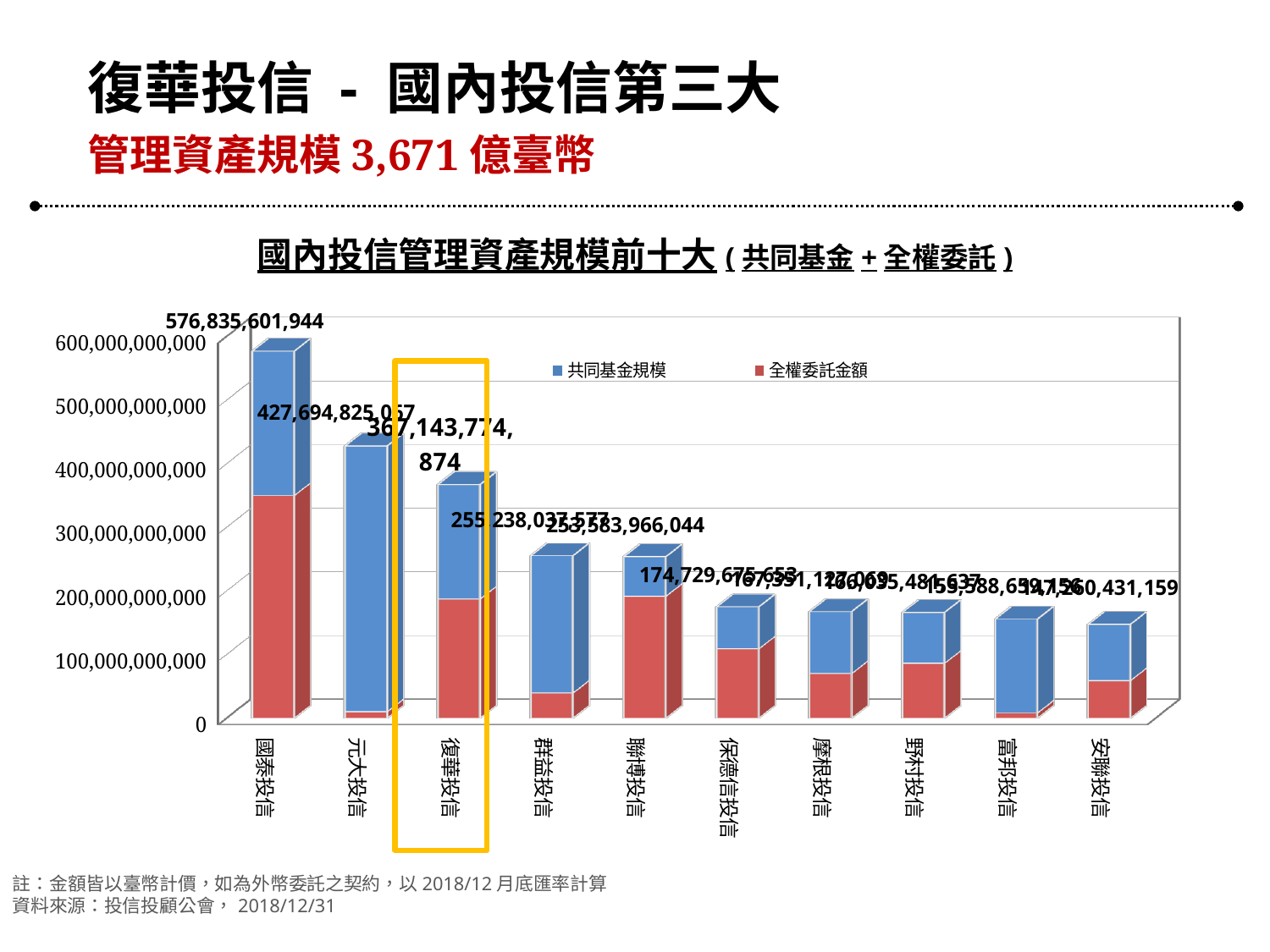
What is the difference between the totals for 國泰投信 and 復華投信? 209,691,827,070 What is the total value labelled for 聯博投信? 253,583,966,044 Do the total values rise or fall moving from left to right along the x axis? fall Is the total for 群益投信 greater or less than 200,000,000,000? greater What are the two series named in the chart legend? 共同基金規模 and 全權委託金額 How many series does the chart legend list? 2 How many investment trust companies are shown on the x axis of the chart? 10 What is the total value labelled for 復華投信? 367,143,774,874 Is the total for 保德信投信 greater or less than 200,000,000,000? less What kind of chart is shown on the slide? Stacked bar chart What is the total value labelled for 國泰投信? 576,835,601,944 Which company has the highest total assets under management in the chart? 國泰投信